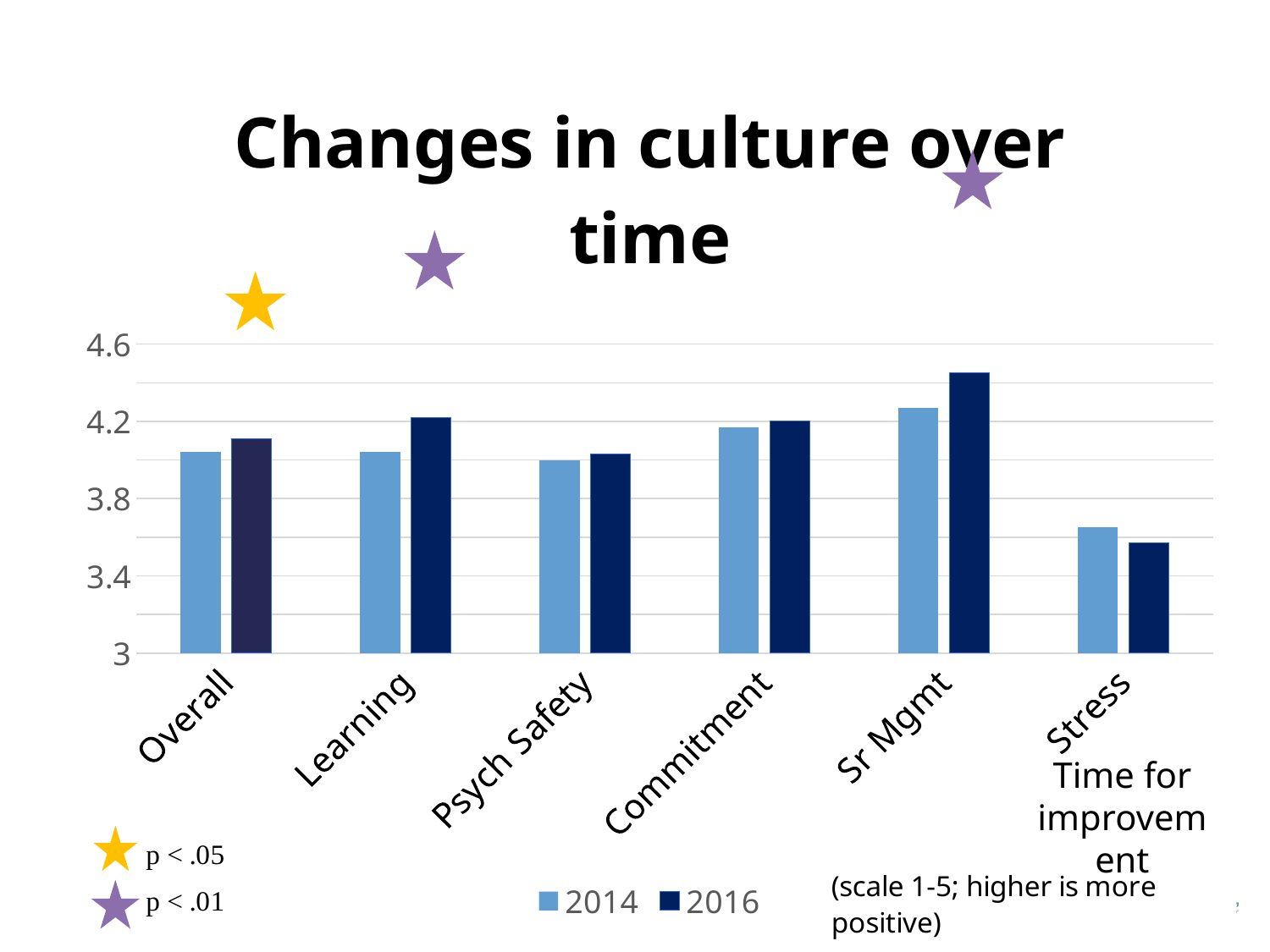
Which category has the lowest 2014 value? Stress How many categories are shown on the x axis? 6 Which two years are listed in the legend? 2014 and 2016 What is the title of the chart? Changes in culture over time For Learning, which year has the larger value, 2014 or 2016? 2016 Is the 2014 value for Stress greater or less than 3.8? less Which category has the lowest 2016 value? Stress How many series does the legend list? 2 For Stress, which year has the larger value, 2014 or 2016? 2014 Is the 2016 value for Sr Mgmt greater or less than 4.2? greater Which category has the highest 2016 value? Sr Mgmt What type of chart is shown on the slide? bar chart